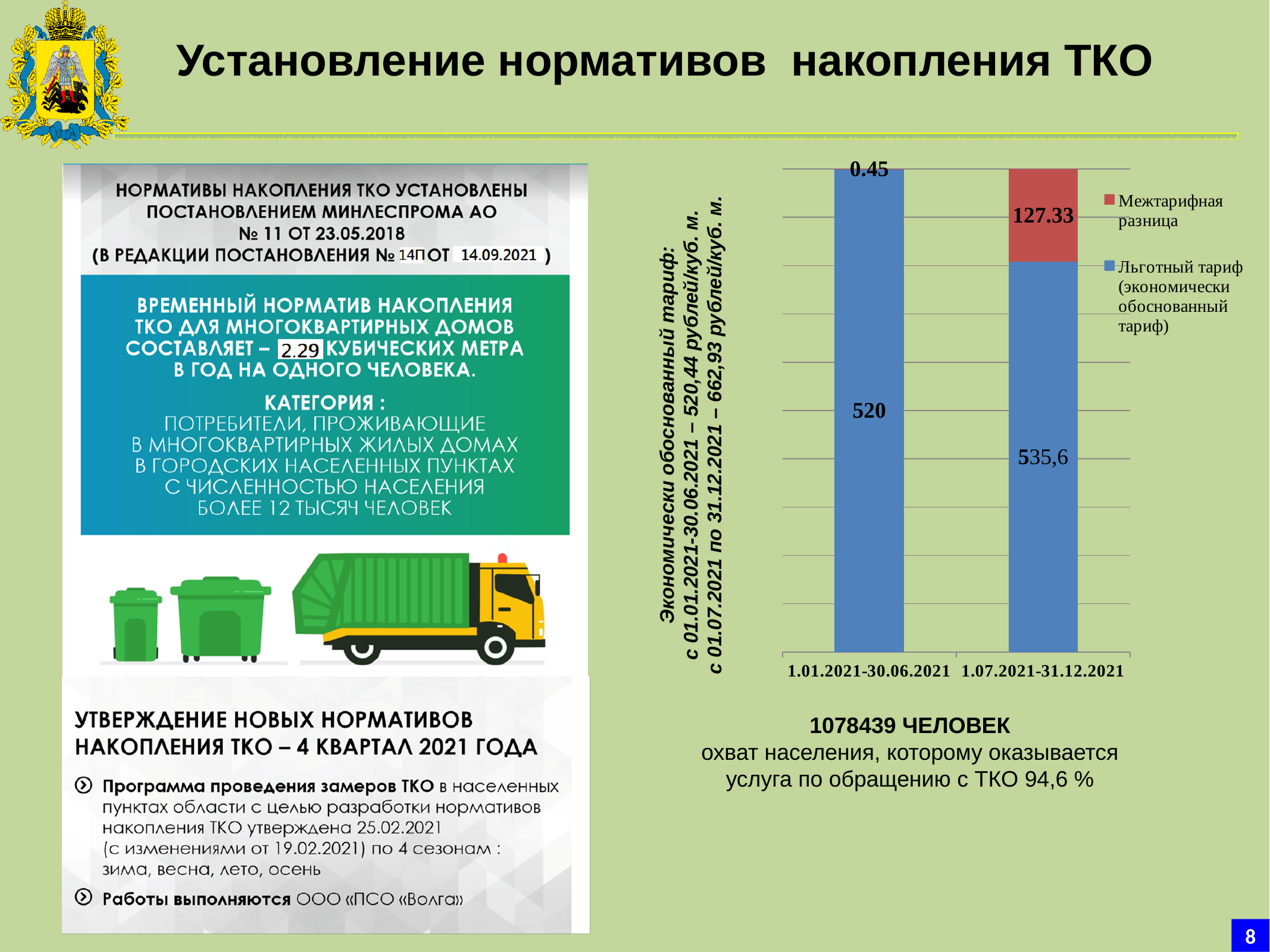
What is the value of Льготный тариф for the period 1.01.2021-30.06.2021? 520 How many categories (periods) are shown on the x axis of the chart? 2 What type of chart is shown on the slide? stacked bar chart Which period has the higher value of Межтарифная разница? 1.07.2021-31.12.2021 What is the total of the stacked bar for 1.01.2021-30.06.2021? 520.45 What is the value of Межтарифная разница for the period 1.01.2021-30.06.2021? 0.45 Which period has the lower value of Льготный тариф? 1.01.2021-30.06.2021 What is the value of Межтарифная разница for the period 1.07.2021-31.12.2021? 127.33 Which colour represents Межтарифная разница in the chart? red What is the difference between the Межтарифная разница values for 1.07.2021-31.12.2021 and 1.01.2021-30.06.2021? 126.88 What is the value of Льготный тариф for the period 1.07.2021-31.12.2021? 535,6 How many series does the chart legend list? 2